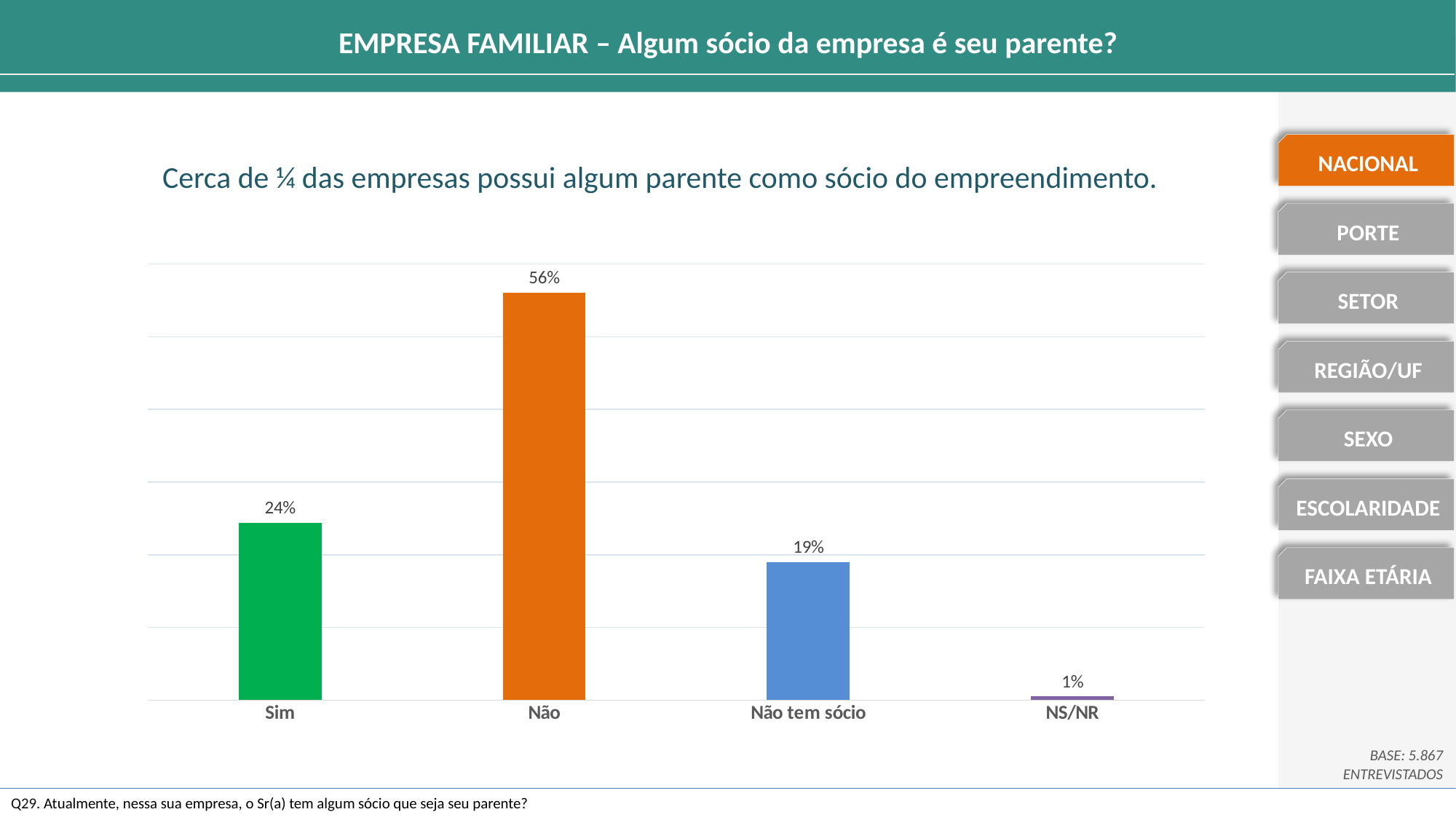
What kind of chart is shown on the slide? Bar chart Which is larger, the value for "Sim" or the value for "Não tem sócio"? Sim What is the difference between the values for "Sim" and "Não tem sócio"? 5% What is the value for "Sim"? 24% What is the value for "NS/NR"? 1% What is the value for "Não tem sócio"? 19% What colour is the bar for "Não"? Orange What is the difference between the values for "Não" and "Sim"? 32% How many categories are shown on the x axis? 4 Which category has the highest value? Não Which category has the lowest value? NS/NR What is the value for "Não"? 56%